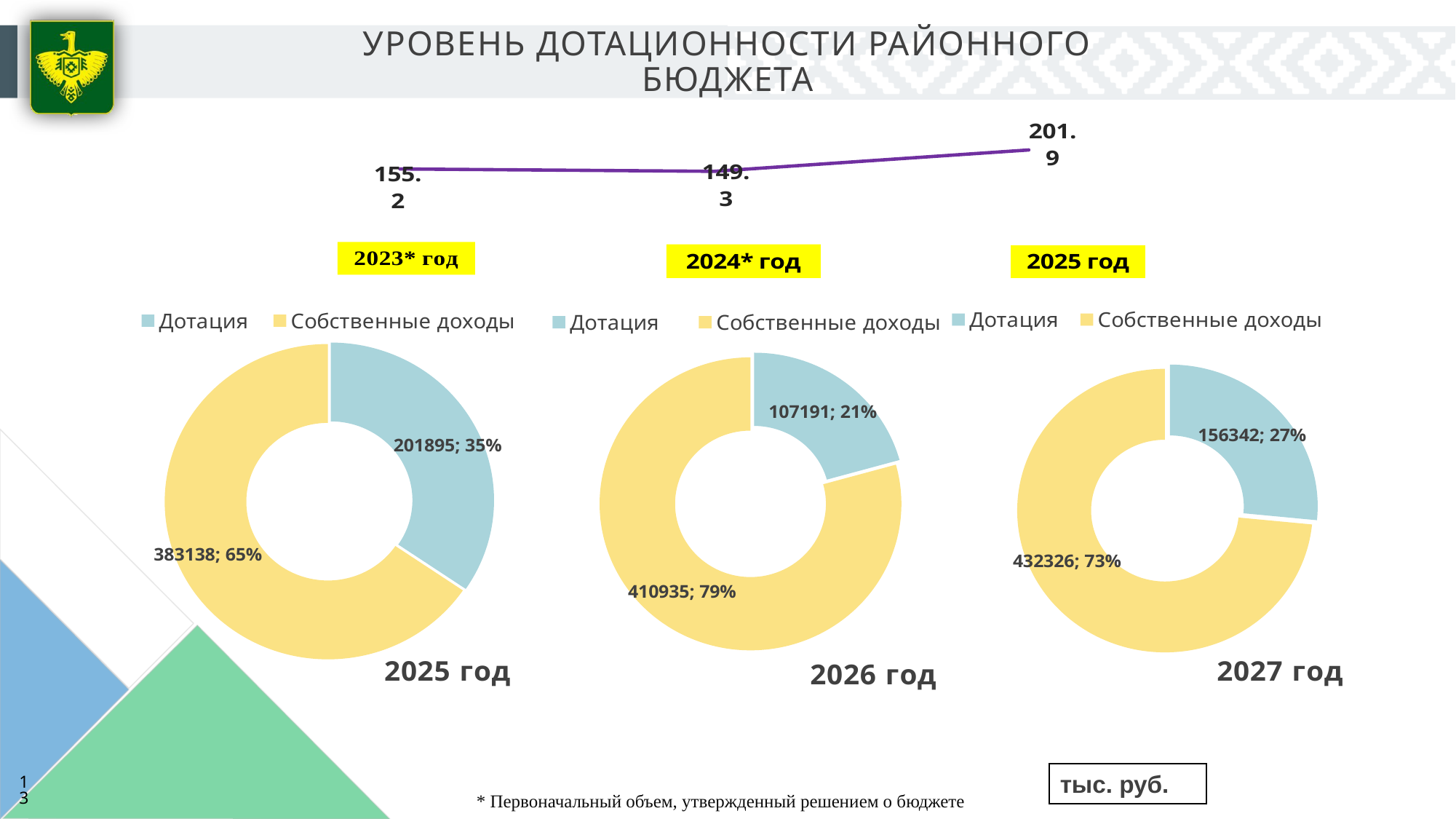
What kind of chart is shown at the top of the slide above the year labels? Line chart In the donut chart titled "2027 год", what share of the total does Собственные доходы make up? 73% In the donut chart titled "2025 год", what value is shown for Дотация? 201895; 35% How many series does the legend of the donut chart titled "2027 год" list? 2 In the line chart at the top of the slide, what is the difference between the values for 2025 год and 2023* год? 46.7 In the donut chart titled "2027 год", what value is shown for Дотация? 156342; 27% In the line chart at the top of the slide, which year has the highest value? 2025 год In the donut chart titled "2026 год", what share of the total does Дотация make up? 21% In the donut chart titled "2025 год", which is larger: Дотация or Собственные доходы? Собственные доходы In the donut chart titled "2026 год", what is the total of Дотация and Собственные доходы? 518126 In the line chart at the top of the slide, what value is shown for 2024* год? 149.3 In the donut chart titled "2026 год", what value is shown for Собственные доходы? 410935; 79%